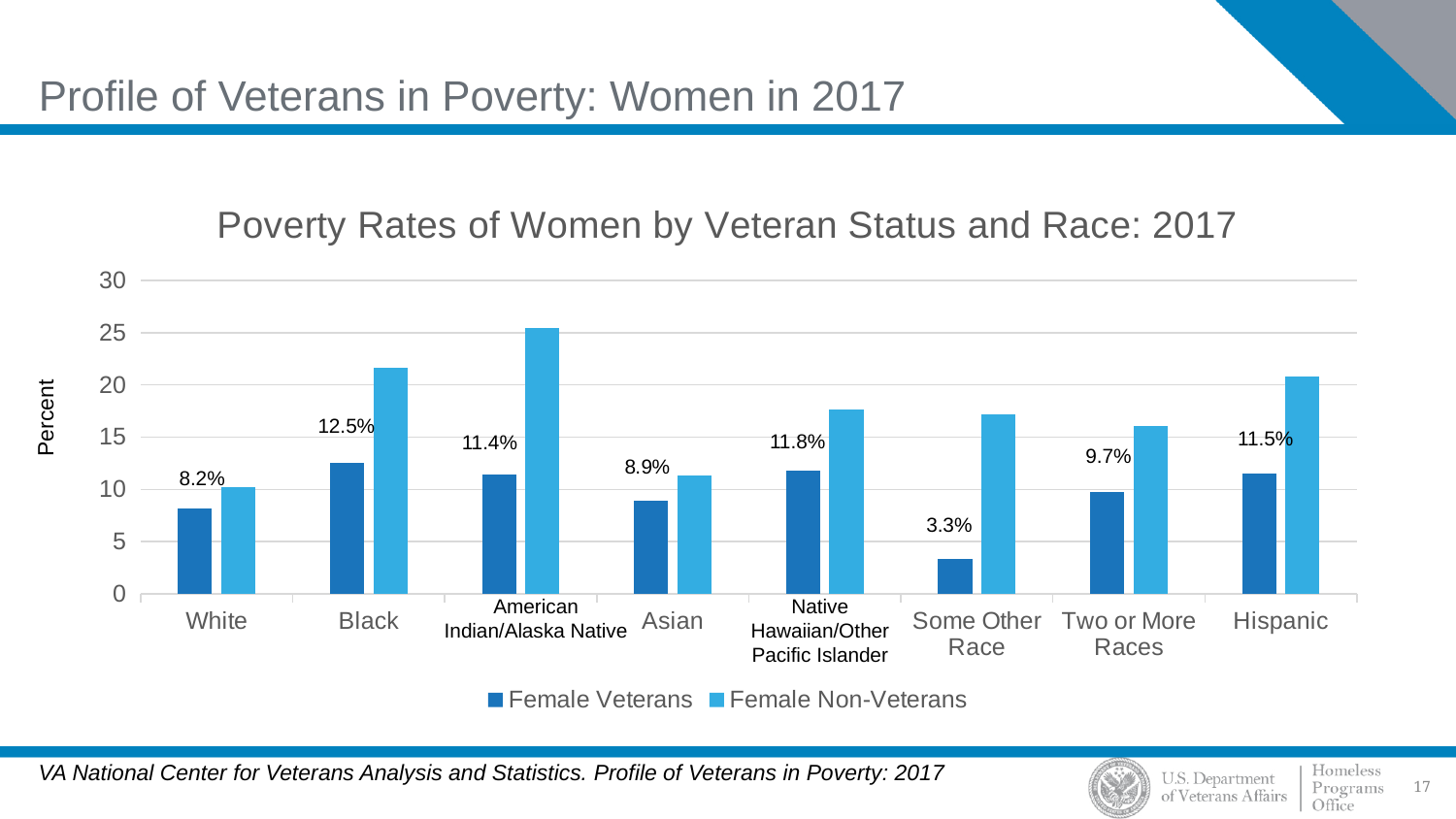
For Hispanic women, which series has the higher poverty rate, Female Veterans or Female Non-Veterans? Female Non-Veterans Is the Female Non-Veterans poverty rate for Black women greater or less than 20? greater What is the poverty rate for Female Veterans in the Some Other Race category? 3.3% What is the poverty rate for Female Veterans in the Black category? 12.5% Which race category has the highest poverty rate for Female Veterans? Black What is the poverty rate for Female Veterans in the Two or More Races category? 9.7% How many race categories are shown on the x axis? 8 Which is larger, the Female Veterans poverty rate for Asian women or for White women? Asian What is the difference between the Female Veterans poverty rates for Black and White women? 4.3% Which race category has the lowest poverty rate for Female Veterans? Some Other Race How many series does the legend list? 2 Is the Female Non-Veterans poverty rate for White women greater or less than 15? less